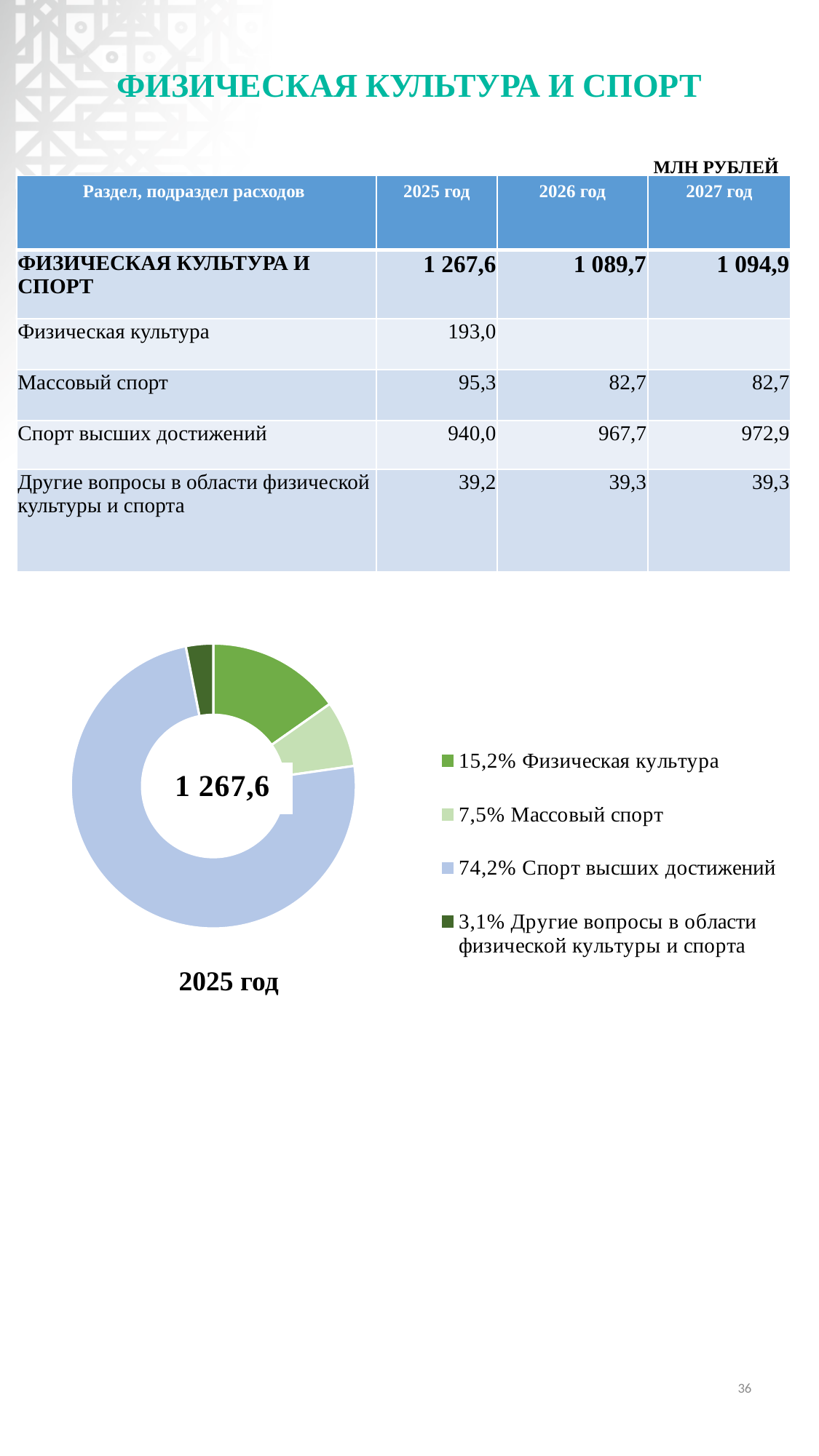
Which year does the doughnut chart represent, according to the label below it? 2025 год What share of the doughnut chart does Массовый спорт take? 7,5% What kind of chart is shown on the slide? doughnut chart What is the difference in percentage points between the shares of Физическая культура and Массовый спорт in the doughnut chart? 7,7 What share of the doughnut chart does Физическая культура take? 15,2% Which category has the largest slice in the doughnut chart? Спорт высших достижений Which slice is larger in the doughnut chart: Физическая культура or Массовый спорт? Физическая культура What share of the doughnut chart does Другие вопросы в области физической культуры и спорта take? 3,1% How many categories does the doughnut chart show? 4 What total value is printed in the centre of the doughnut chart? 1 267,6 Which category has the smallest slice in the doughnut chart? Другие вопросы в области физической культуры и спорта